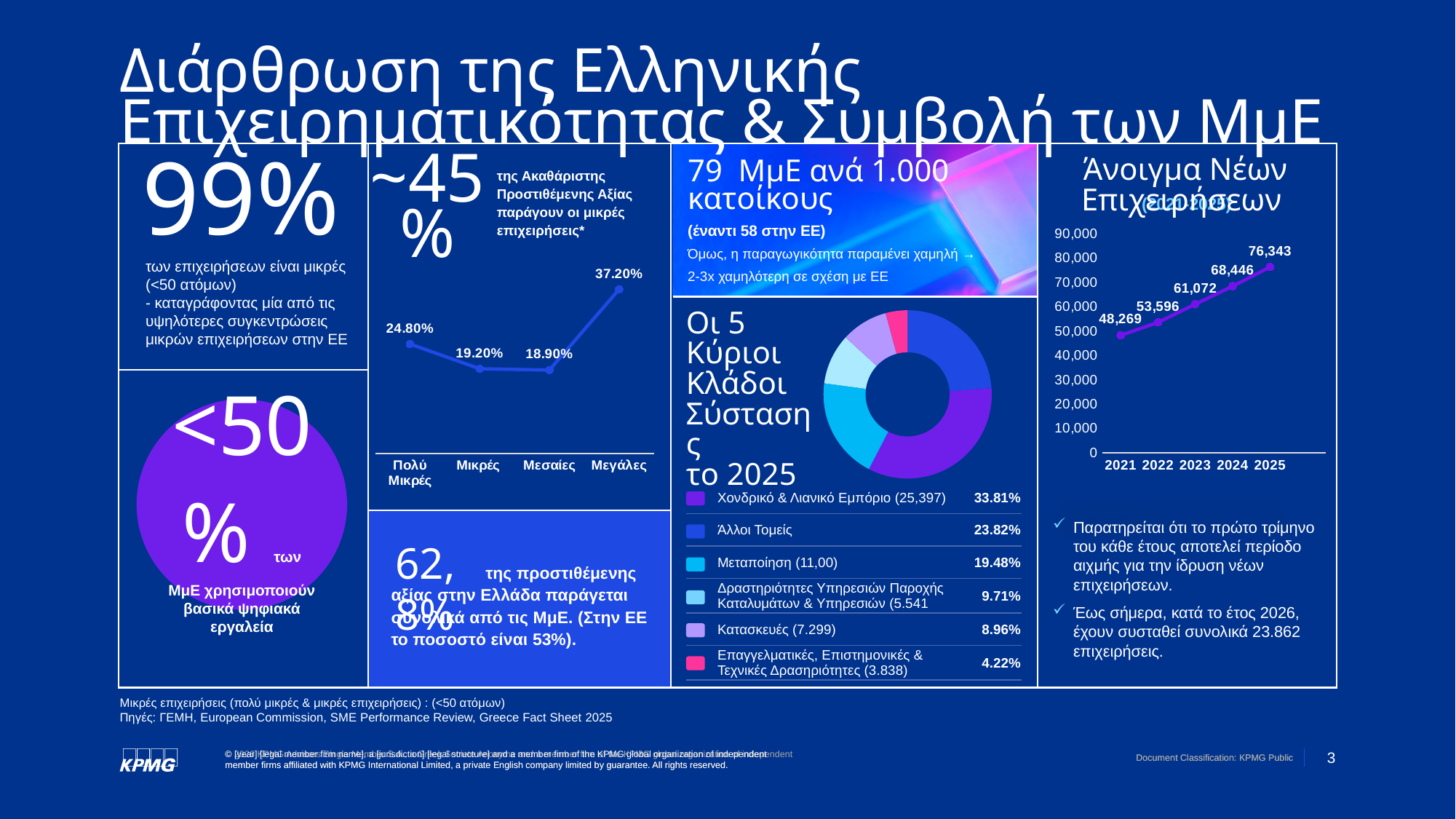
In the line chart with categories Πολύ Μικρές, Μικρές, Μεσαίες and Μεγάλες, what is the difference between Πολύ Μικρές and Μικρές? 5.60% How many years are plotted in the 'Άνοιγμα Νέων Επιχειρήσεων' chart? 5 In the line chart with categories Πολύ Μικρές, Μικρές, Μεσαίες and Μεγάλες, what is the value for Μεγάλες? 37.20% In the donut chart 'Οι 5 Κύριοι Κλάδοι Σύστασης το 2025', which sector has the largest share? Χονδρικό & Λιανικό Εμπόριο In the donut chart 'Οι 5 Κύριοι Κλάδοι Σύστασης το 2025', what share does Μεταποίηση have? 19.48% In the line chart with categories Πολύ Μικρές, Μικρές, Μεσαίες and Μεγάλες, which category has the lowest value? Μεσαίες In the 'Άνοιγμα Νέων Επιχειρήσεων' chart, what is the difference between the 2025 and 2024 values? 7,897 In the 'Άνοιγμα Νέων Επιχειρήσεων' chart, which year has the lowest value? 2021 In the 'Άνοιγμα Νέων Επιχειρήσεων' chart, what is the value for 2021? 48,269 What type of chart is 'Οι 5 Κύριοι Κλάδοι Σύστασης το 2025'? donut (pie) chart In the 'Άνοιγμα Νέων Επιχειρήσεων' chart, do the values rise or fall from 2021 to 2025? rise In the 'Άνοιγμα Νέων Επιχειρήσεων' chart, what is the value for 2025? 76,343